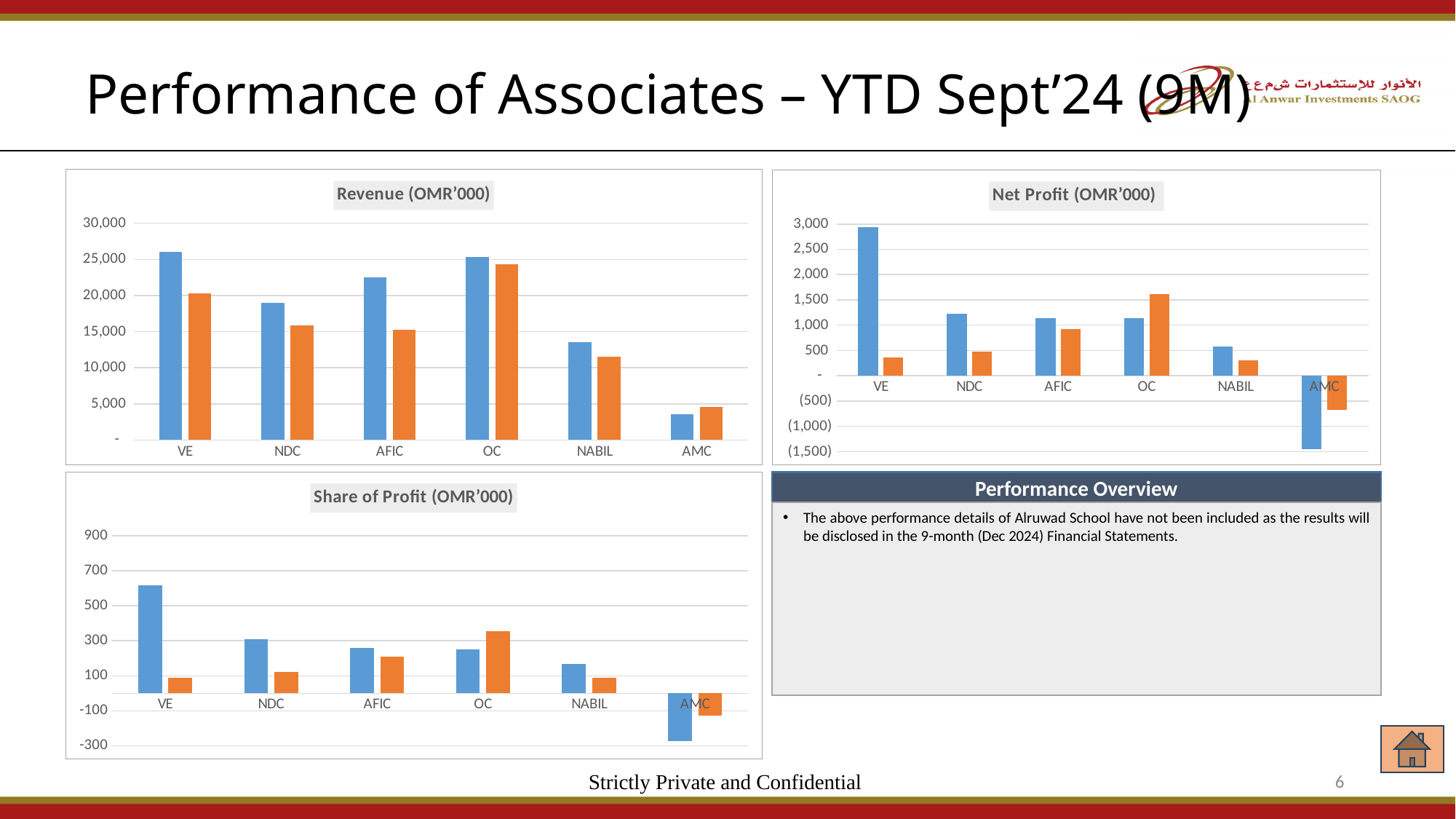
What is the title of the chart at the bottom left of the slide? Share of Profit (OMR'000) On the Share of Profit (OMR'000) chart, is the blue bar for VE greater or less than 500? greater On the Revenue (OMR'000) chart, which associate has the lowest blue bar? AMC How many associates (categories) are shown on the Revenue (OMR'000) chart? 6 On the Net Profit (OMR'000) chart, is the blue bar for VE greater or less than 2,500? greater On the Revenue (OMR'000) chart, is the blue bar for NDC greater or less than 20,000? less On the Net Profit (OMR'000) chart, which associate has the highest blue bar? VE What kind of chart is the Revenue (OMR'000) chart? bar chart On the Net Profit (OMR'000) chart, for OC, which bar is larger, the blue or the orange? orange On the Revenue (OMR'000) chart, for AMC, which bar is larger, the blue or the orange? orange On the Net Profit (OMR'000) chart, which associate has the lowest blue bar? AMC